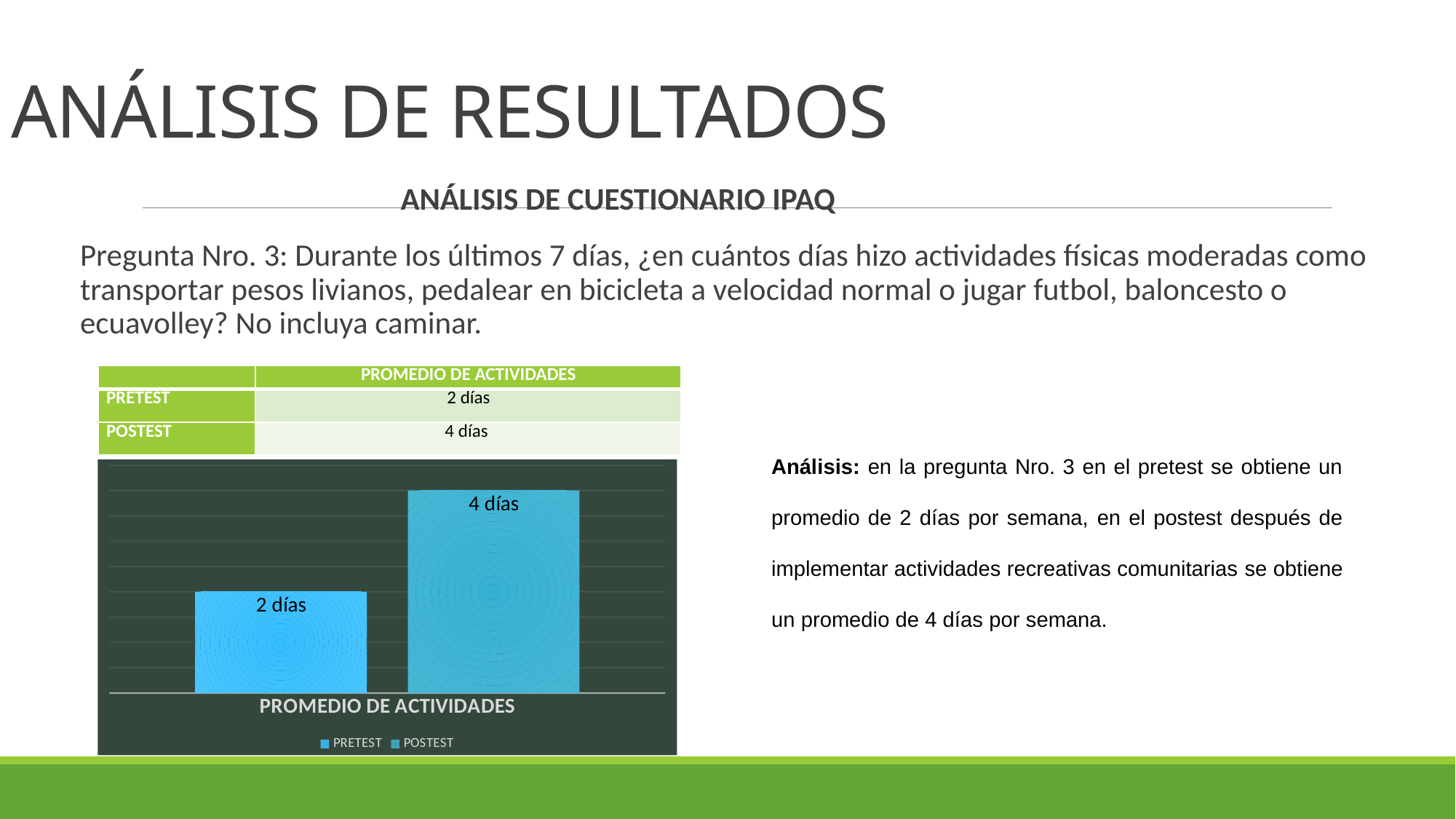
Which series has the lowest value in the chart? PRETEST How many bars are plotted in the chart? 2 What is the value for POSTEST in the chart? 4 días What kind of chart is shown on the slide? Bar chart Which series has the higher value, PRETEST or POSTEST? POSTEST What is the category label shown on the x axis of the chart? PROMEDIO DE ACTIVIDADES What is the value for PRETEST in the chart? 2 días How many series does the chart legend list? 2 Which series has the highest value in the chart? POSTEST What are the two legend entries of the chart? PRETEST and POSTEST What is the difference in days between POSTEST and PRETEST? 2 días